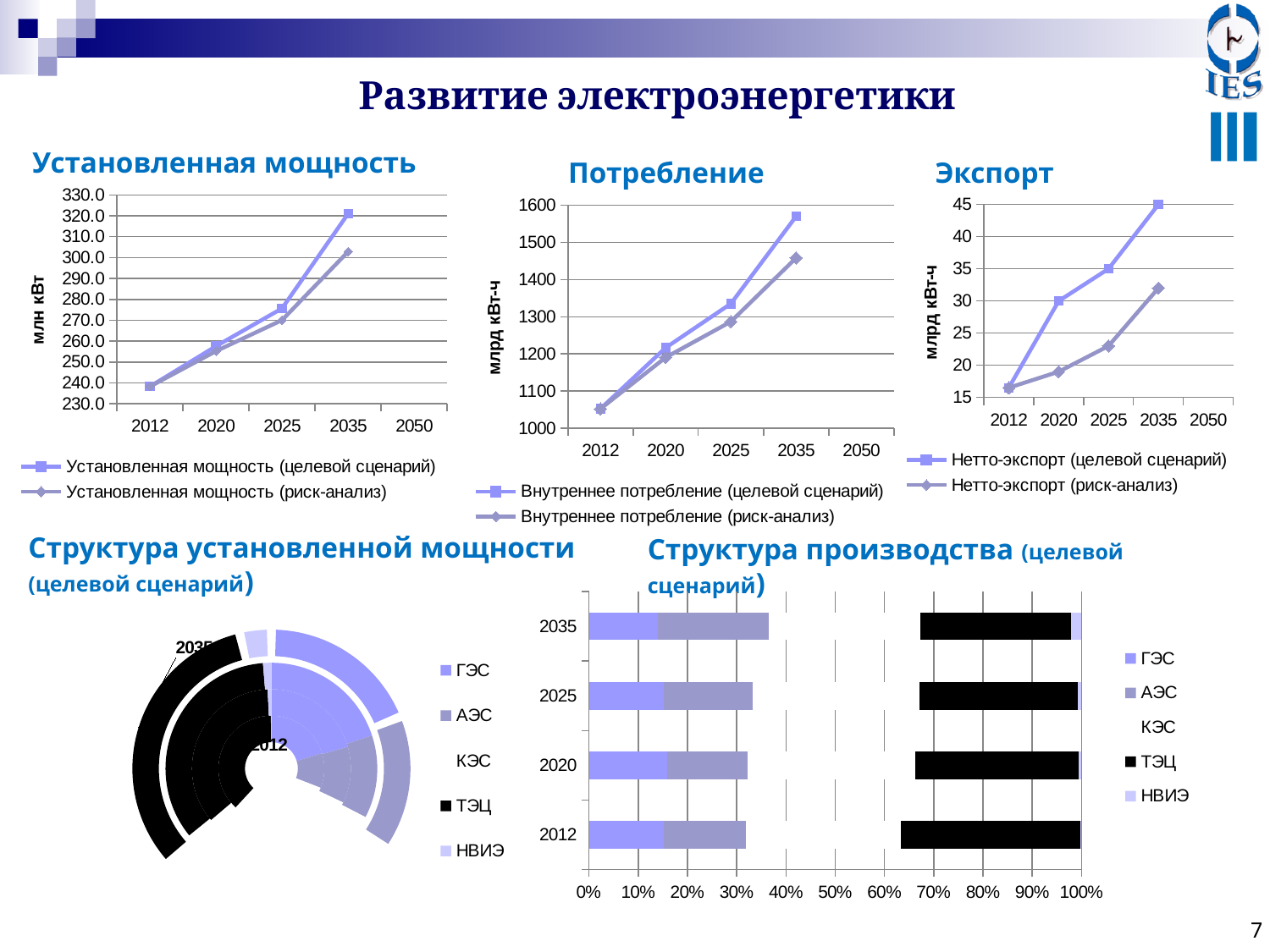
In the "Установленная мощность" chart, is the 2035 value for "Установленная мощность (риск-анализ)" greater or less than 310.0? less In the "Экспорт" chart, which series has the larger value in 2035: "Нетто-экспорт (целевой сценарий)" or "Нетто-экспорт (риск-анализ)"? Нетто-экспорт (целевой сценарий) In the "Структура производства (целевой сценарий)" chart, how many years are shown on the vertical axis? 4 What kind of chart is the "Установленная мощность" chart? line chart In the "Потребление" chart, is the 2035 value for "Внутреннее потребление (целевой сценарий)" greater or less than 1500? greater In the "Потребление" chart, how many series does the legend list? 2 In the "Потребление" chart, does the "Внутреннее потребление (целевой сценарий)" series rise or fall from 2012 to 2035? rises In the "Структура производства (целевой сценарий)" chart, how many entries does the legend list? 5 In the "Экспорт" chart, how many year labels appear on the x axis? 5 What kind of chart is the "Структура производства (целевой сценарий)" chart? bar chart In the "Установленная мощность" chart, is the 2035 value for "Установленная мощность (целевой сценарий)" greater or less than 310.0? greater In the "Экспорт" chart, what is the 2035 value for "Нетто-экспорт (целевой сценарий)"? 45